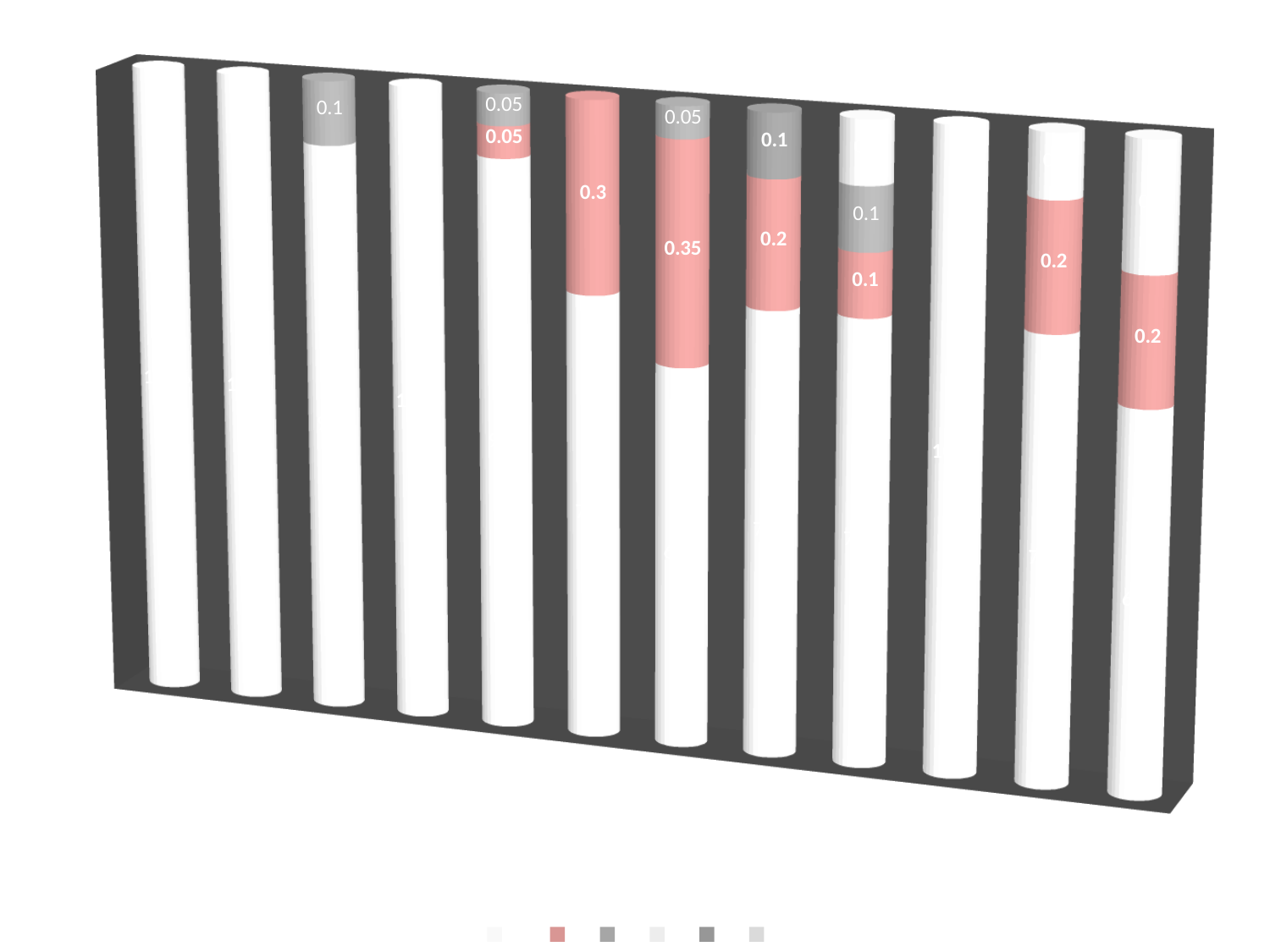
What kind of chart is shown on the slide? Stacked bar chart Which bar has the largest labelled pink segment? The seventh bar from the left (0.35) What value is labelled on the pink segment of the sixth bar from the left? 0.3 Which is larger: the pink segment of the sixth bar from the left or the pink segment of the eighth bar from the left? The sixth bar (0.3) What value is labelled on the pink segment of the seventh bar from the left? 0.35 What value is labelled on the pink segment of the rightmost bar? 0.2 How many colour swatches does the legend show? 6 What value is labelled on the grey segment of the eighth bar from the left? 0.1 What value is labelled on the grey segment of the third bar from the left? 0.1 What are the two labelled values on the fifth bar from the left? 0.05 and 0.05 What is the difference between the pink segment values of the seventh and sixth bars from the left? 0.05 How many bars are plotted in the chart? 12